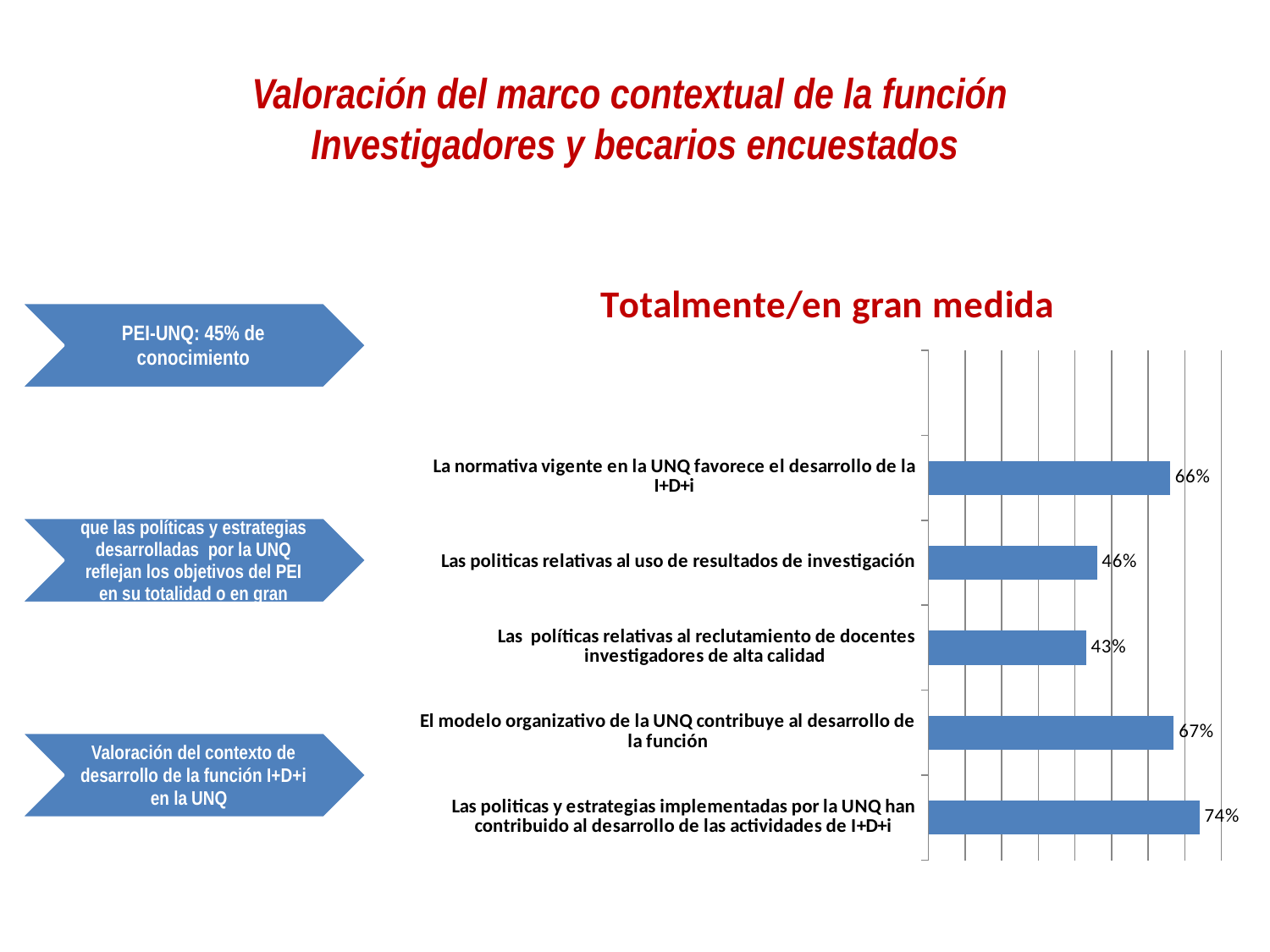
Which category has the highest value? Las politicas y estrategias implementadas por la UNQ han contribuido al desarrollo de las actividades de I+D+i Which category has the lowest value? Las políticas relativas al reclutamiento de docentes investigadores de alta calidad What is the value for "Las politicas y estrategias implementadas por la UNQ han contribuido al desarrollo de las actividades de I+D+i"? 74% What is the value for "Las políticas relativas al reclutamiento de docentes investigadores de alta calidad"? 43% Which is larger: the value for "La normativa vigente en la UNQ favorece el desarrollo de la I+D+i" or the value for "Las politicas relativas al uso de resultados de investigación"? La normativa vigente en la UNQ favorece el desarrollo de la I+D+i What is the difference between the value for "Las politicas y estrategias implementadas por la UNQ han contribuido al desarrollo de las actividades de I+D+i" and the value for "Las políticas relativas al reclutamiento de docentes investigadores de alta calidad"? 31% What is the value for "Las politicas relativas al uso de resultados de investigación"? 46% How many categories does the chart show? 5 What is the value for "El modelo organizativo de la UNQ contribuye al desarrollo de la función"? 67% What type of chart is shown on the slide? bar chart What is the chart's title? Totalmente/en gran medida What is the value for "La normativa vigente en la UNQ favorece el desarrollo de la I+D+i"? 66%